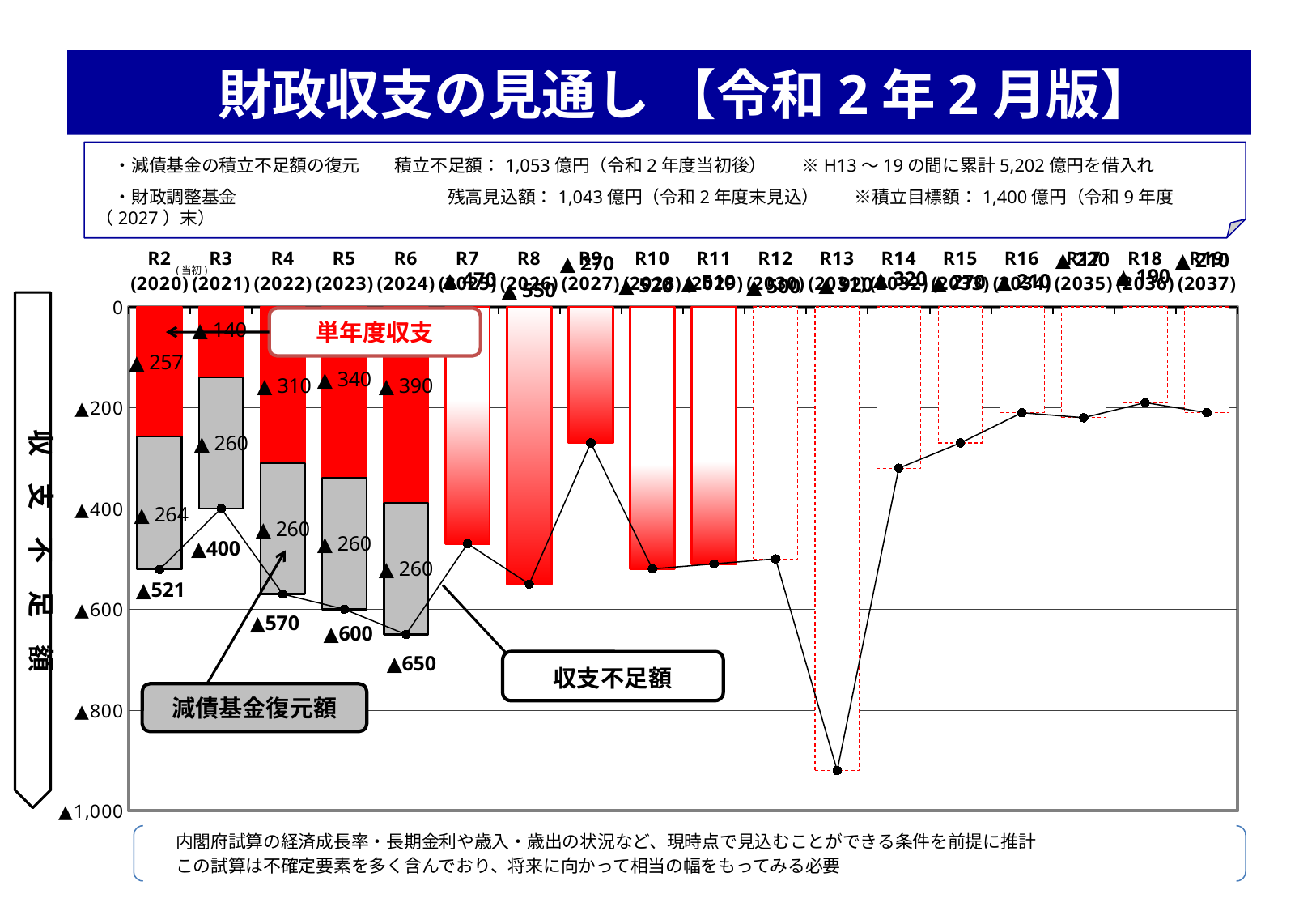
From R2 (2020) to R6 (2024), does the 収支不足額 increase or decrease? Increase What is the title of the slide's chart? 財政収支の見通し【令和2年2月版】 What is the 単年度収支 value shown for R6 (2024)? ▲390 What is the 減債基金復元額 value shown for R3 (2021)? ▲260 Which year has the larger 収支不足額, R4 (2022) or R5 (2023)? R5 (2023) By how much does the 収支不足額 for R6 (2024) exceed that for R2 (2020)? 129 Which year has the smallest 収支不足額 on the line? R18 (2036) What is the 収支不足額 (total shortfall) value shown for R2 (2020)? ▲521 What is the 収支不足額 value shown for R13 (2031)? ▲920 What kind of chart is shown on the slide? Combined bar and line chart How many fiscal years are shown on the x axis of the chart? 18 Which year has the largest 収支不足額 (deepest point on the line)? R13 (2031)